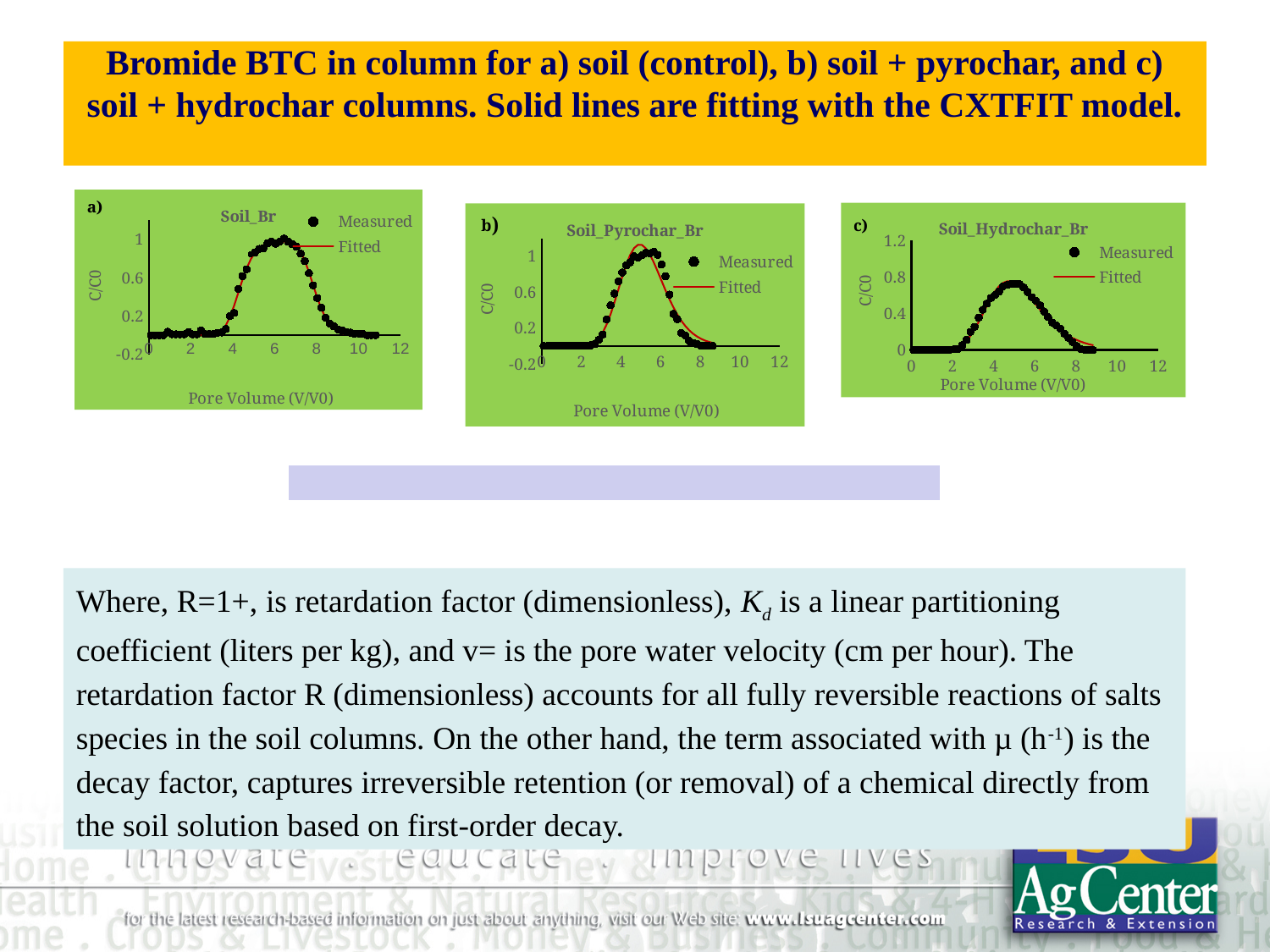
In the Soil_Pyrochar_Br chart, is the peak measured C/C0 value greater or less than 0.6? greater In the Soil_Hydrochar_Br chart, is the measured C/C0 value at pore volume 2 greater or less than 0.4? less Which of the three charts shows the lowest peak C/C0 value? Soil_Hydrochar_Br How many charts are on the slide? 3 How many series does the legend of the Soil_Pyrochar_Br chart list? 2 In the Soil_Br chart, is the measured C/C0 value at pore volume 10 greater or less than 0.2? less What kind of chart is the chart titled Soil_Br? scatter chart with a fitted line What is the x-axis label of the Soil_Br chart? Pore Volume (V/V0) What are the two legend entries in the Soil_Hydrochar_Br chart? Measured and Fitted In the Soil_Br chart, how do the measured C/C0 values change as pore volume increases from 0 to 12? rise then fall